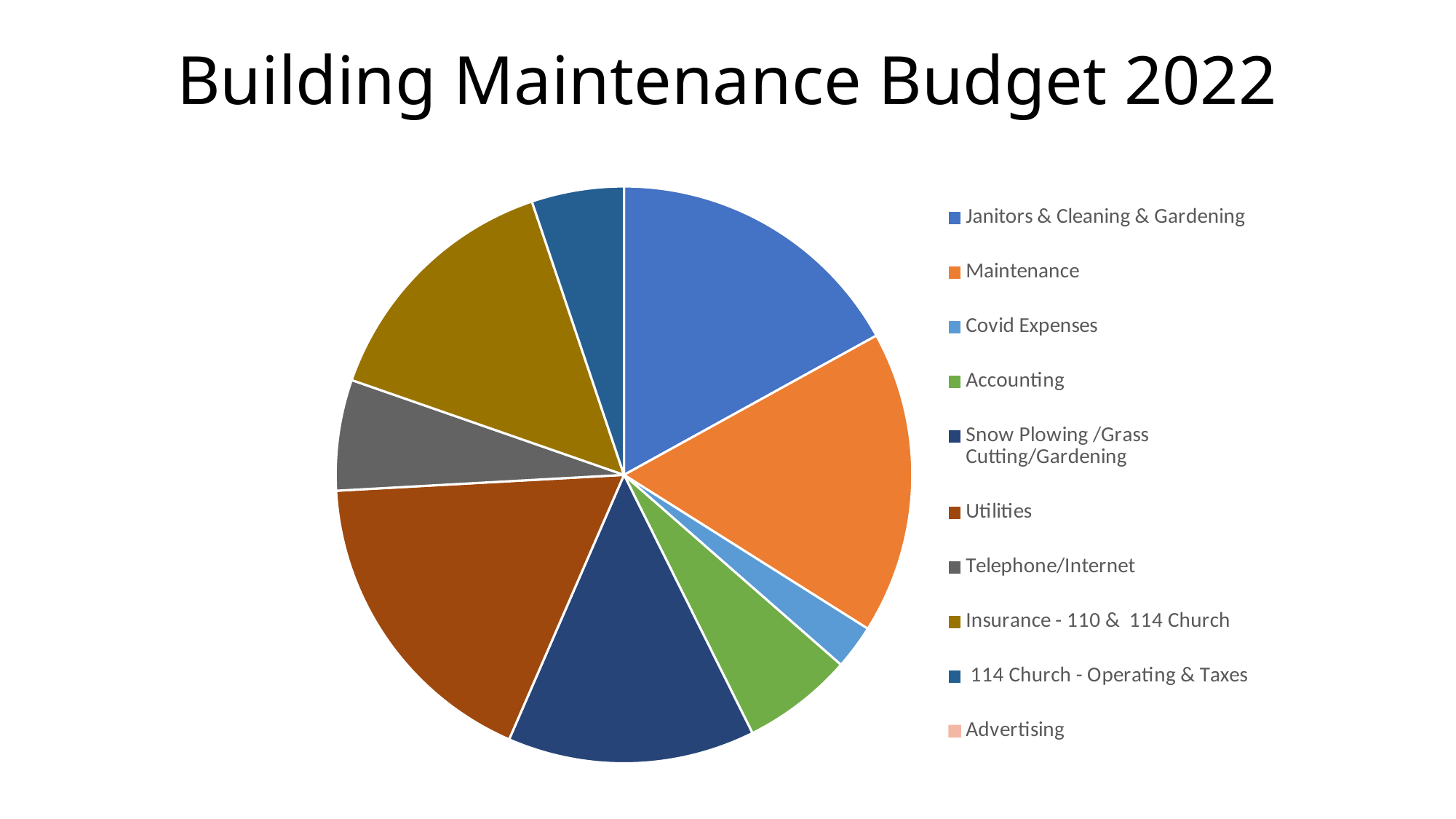
Which slice is larger, Accounting or Snow Plowing /Grass Cutting/Gardening? Snow Plowing /Grass Cutting/Gardening Which slice is larger, Covid Expenses or Accounting? Accounting Which slice is larger, Covid Expenses or Telephone/Internet? Telephone/Internet What kind of chart is shown on the slide? Pie chart How many entries does the chart's legend list? 10 What colour is the Maintenance slice? Orange What is the title of the chart? Building Maintenance Budget 2022